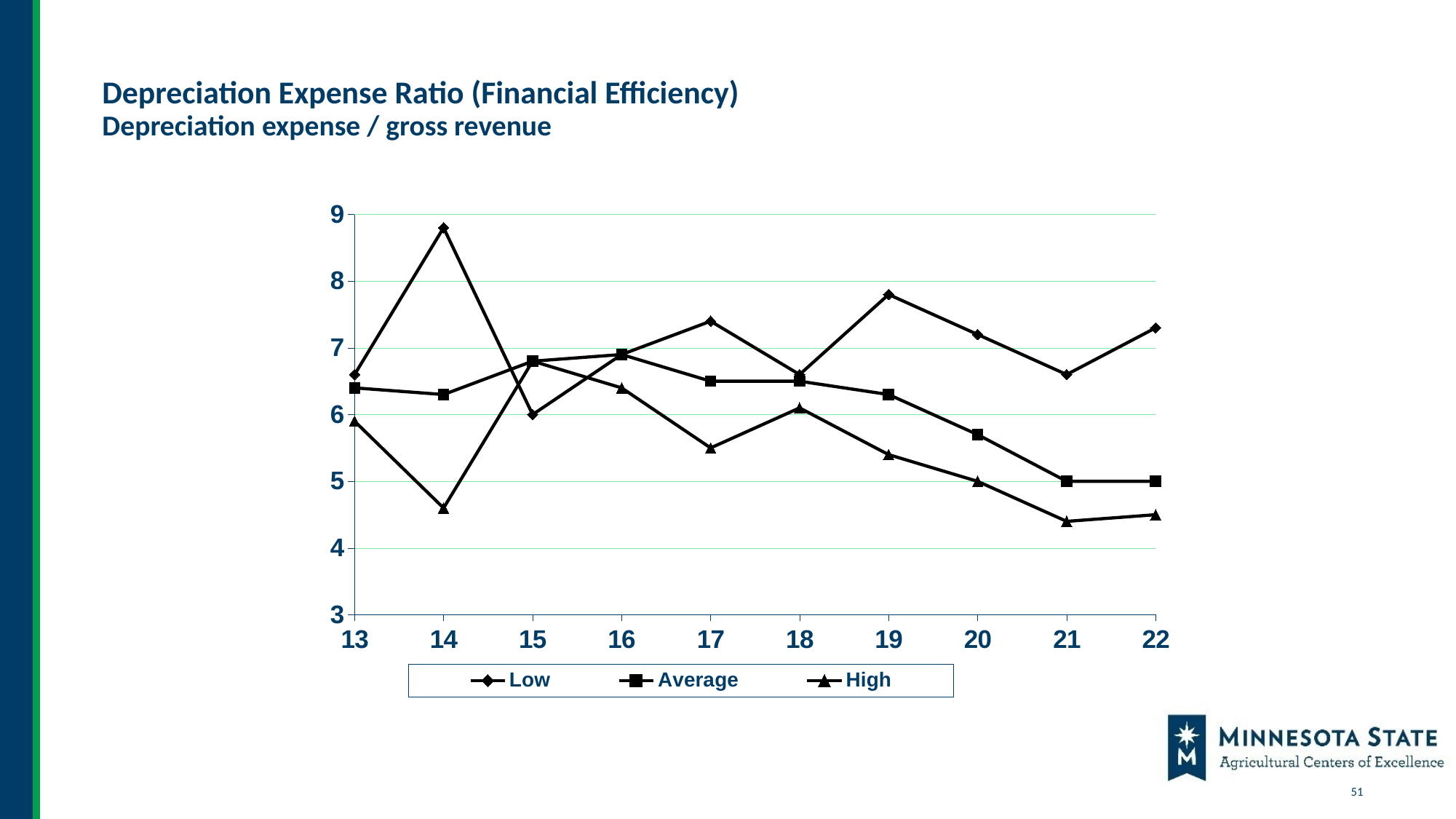
What kind of chart is shown on the slide? line chart Is the value for the Low series in year 19 greater or less than 7? greater How many series does the legend list? 3 Does the Average series rise or fall from year 16 to year 22? fall In which year does the Low series reach its lowest value? 15 What are the three series named in the legend? Low, Average, High In year 19, which series has the larger value, Low or High? Low How many years are plotted along the x axis? 10 In which year does the Low series reach its highest value? 14 Is the value for the Average series in year 20 greater or less than 6? less Is the value for the Low series in year 14 greater or less than 8? greater